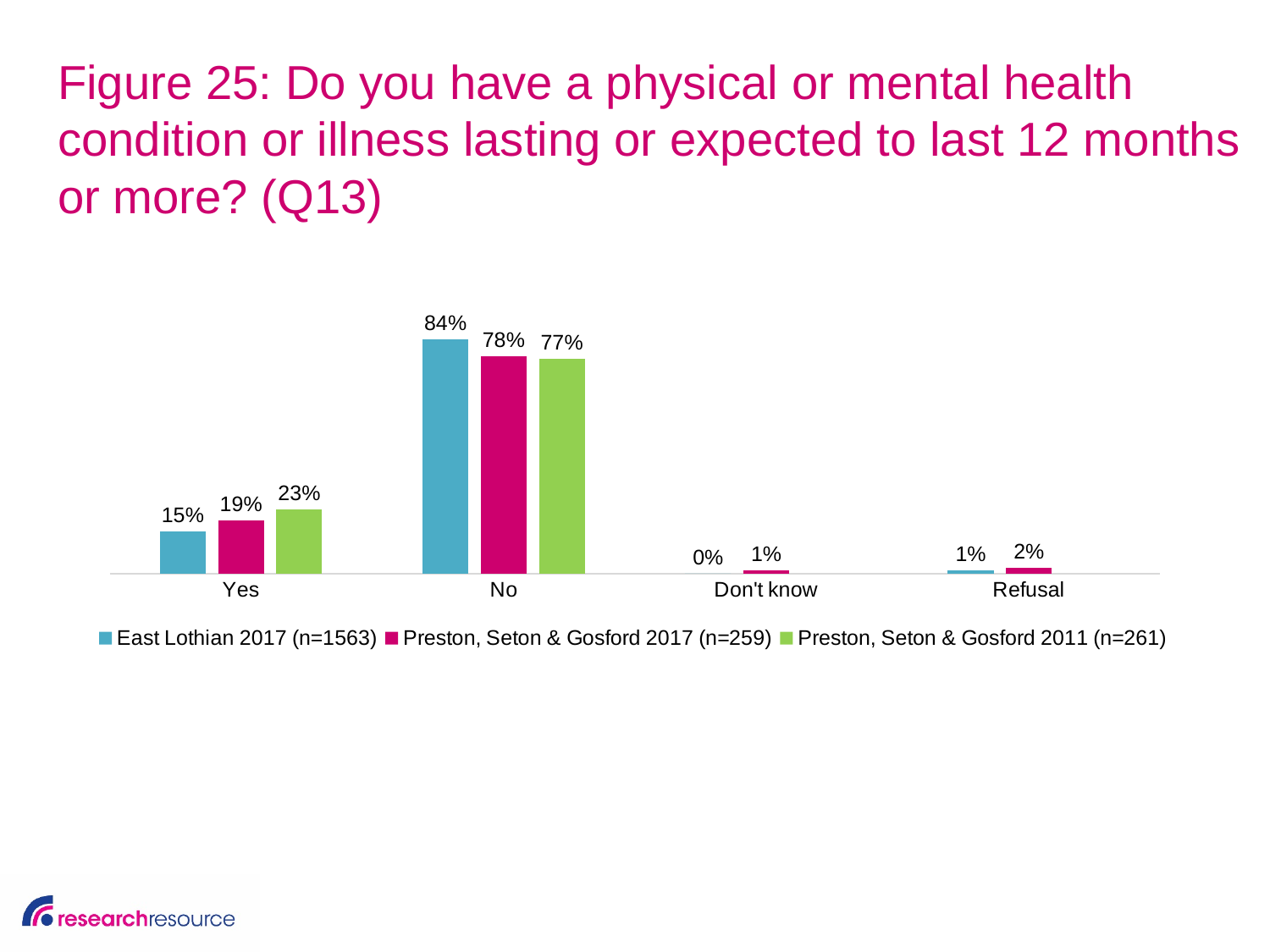
What kind of chart is shown on the slide? Bar chart What is the difference between the Preston, Seton & Gosford 2011 and Preston, Seton & Gosford 2017 values for "Yes"? 4 percentage points How many response categories are shown on the x axis? 4 What is the value for Preston, Seton & Gosford 2011 in the "No" category? 77% What percentage of East Lothian 2017 respondents answered "Yes"? 15% What is the difference between the East Lothian 2017 and Preston, Seton & Gosford 2017 values for "No"? 6 percentage points Which is larger: the Preston, Seton & Gosford 2017 value for "Yes" or the Preston, Seton & Gosford 2011 value for "Yes"? Preston, Seton & Gosford 2011 Which series has the lowest value in the "Yes" category? East Lothian 2017 (n=1563) Which series has the highest value in the "No" category? East Lothian 2017 (n=1563) What percentage of Preston, Seton & Gosford 2017 respondents answered "Refusal"? 2% What is the sample size (n) for the East Lothian 2017 series shown in the legend? 1563 How many series does the legend list? 3